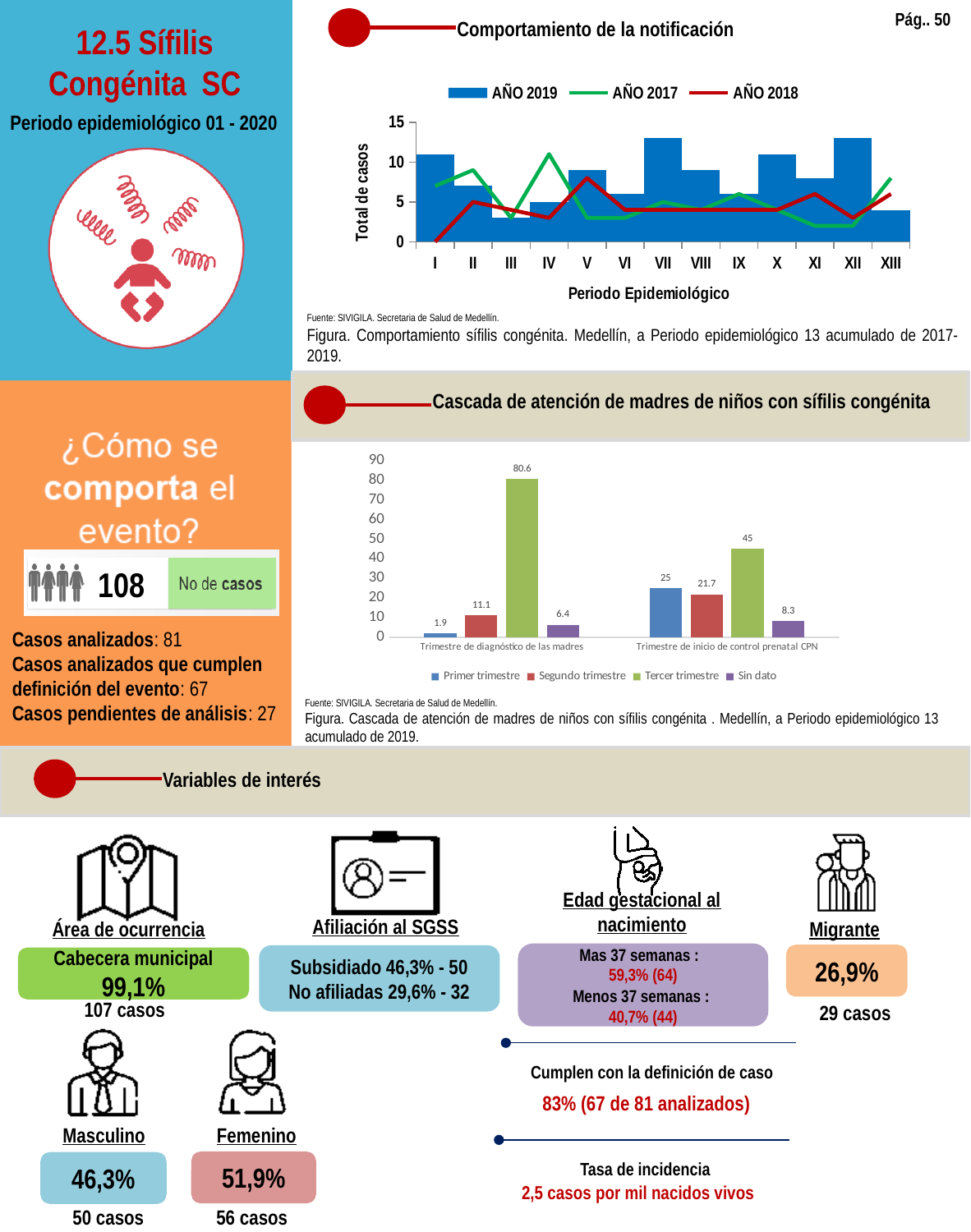
In the 'Cascada de atención' chart, what is the value for Tercer trimestre in 'Trimestre de diagnóstico de las madres'? 80.6 In the 'Cascada de atención' chart, what is the difference between Tercer trimestre and Primer trimestre in 'Trimestre de inicio de control prenatal CPN'? 20 What kind of chart is the 'Cascada de atención' chart? bar chart In the 'Comportamiento de la notificación' chart, is the AÑO 2019 value for period VII greater or less than 10? greater In the 'Cascada de atención' chart, what is the value for Primer trimestre in 'Trimestre de inicio de control prenatal CPN'? 25 In the 'Cascada de atención' chart, what is the value for Sin dato in 'Trimestre de diagnóstico de las madres'? 6.4 How many epidemiological periods are shown on the x axis of the 'Comportamiento de la notificación' chart? 13 In the 'Cascada de atención' chart, which series has the highest value in 'Trimestre de inicio de control prenatal CPN'? Tercer trimestre In the 'Cascada de atención' chart, which series has the lowest value in 'Trimestre de diagnóstico de las madres'? Primer trimestre In the 'Comportamiento de la notificación' chart, is the AÑO 2019 value for period III greater or less than 5? less How many series does the legend of the 'Cascada de atención' chart list? 4 In the 'Cascada de atención' chart, which is larger in 'Trimestre de inicio de control prenatal CPN': Primer trimestre or Segundo trimestre? Primer trimestre